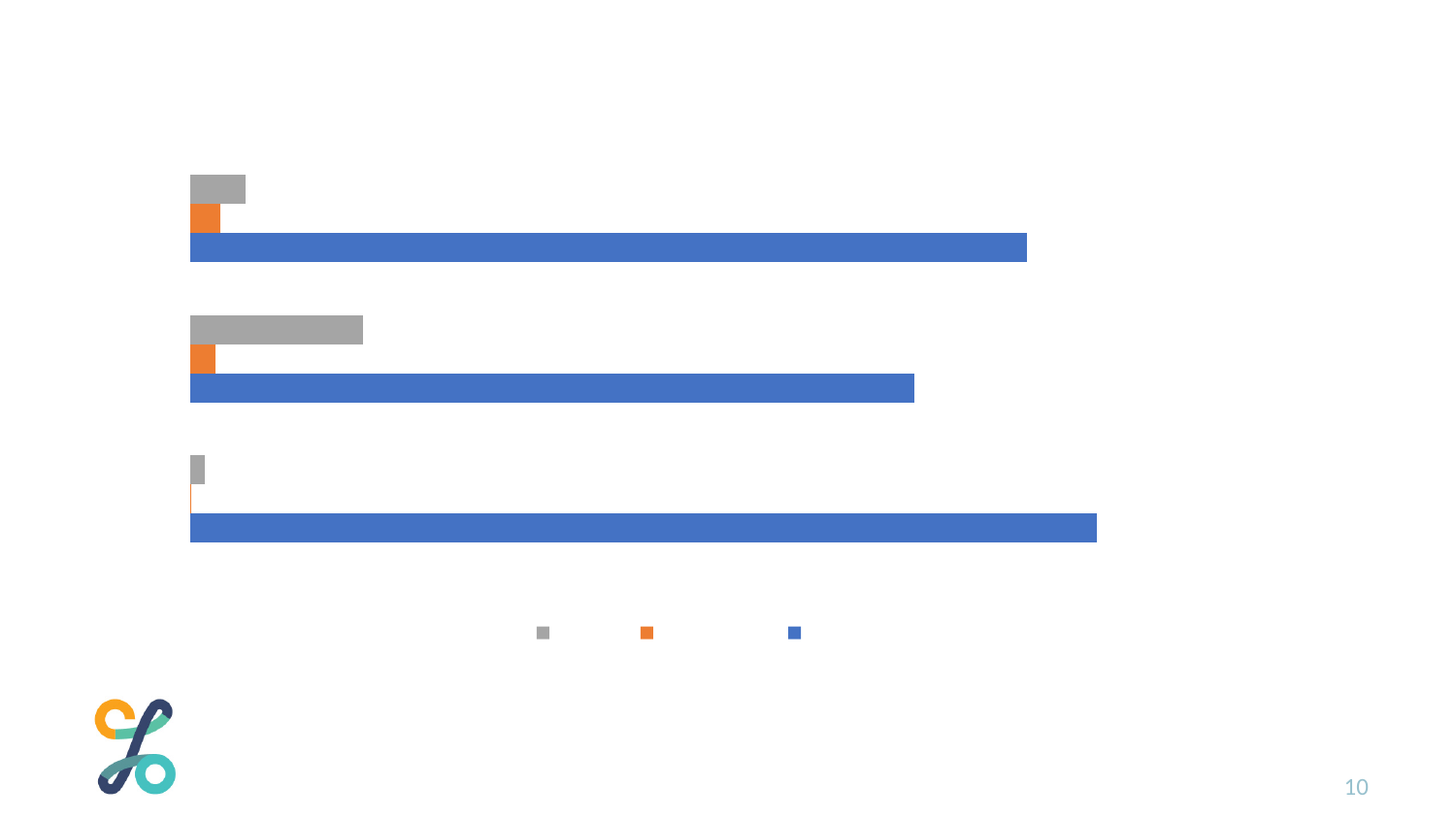
What kind of chart is shown on the slide? bar chart In the middle group of bars, is the orange bar longer or shorter than the grey bar? shorter Which group of bars (top, middle or bottom) has the longest grey bar? middle Which group of bars (top, middle or bottom) has the longest blue bar? bottom Which group of bars (top, middle or bottom) has the shortest orange bar? bottom How many series does the legend list? 3 In the bottom group of bars, is the blue bar longer or shorter than the grey bar? longer Which colour series has the longest bar in every group of the chart? blue What three colours are used for the series in the chart? grey, orange and blue How many groups of bars are plotted in the chart? 3